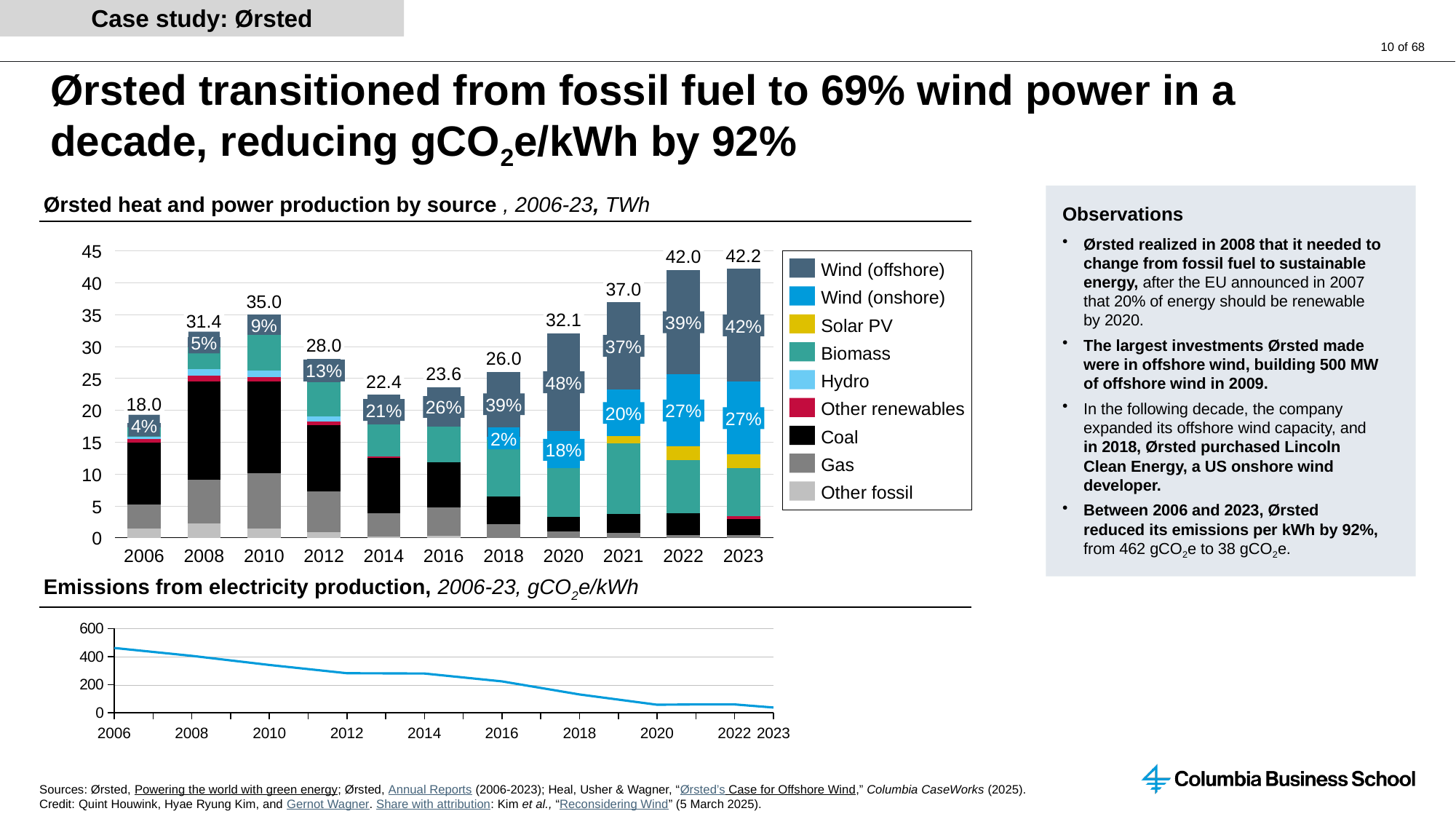
In the 'Ørsted heat and power production by source' chart, what is the total production shown for 2023? 42.2 In the 'Ørsted heat and power production by source' chart, what percentage share is labelled on the Wind (onshore) segment for 2018? 2% What kind of chart is the 'Ørsted heat and power production by source' chart? Stacked bar chart In the 'Emissions from electricity production' chart, do the values rise or fall from 2006 to 2023? fall In the 'Ørsted heat and power production by source' chart, which year has the lowest total production? 2006 How many years are shown on the x axis of the 'Ørsted heat and power production by source' chart? 11 How many series does the legend of the 'Ørsted heat and power production by source' chart list? 9 In the 'Emissions from electricity production' chart, is the value for 2006 greater or less than 400? greater In the 'Ørsted heat and power production by source' chart, what is the difference between the total for 2022 and the total for 2006? 24.0 In the 'Ørsted heat and power production by source' chart, which year has the highest total production? 2023 In the 'Ørsted heat and power production by source' chart, what percentage share is labelled on the Wind (offshore) segment for 2020? 48% In the 'Ørsted heat and power production by source' chart, which total is larger: 2010 or 2020? 2010